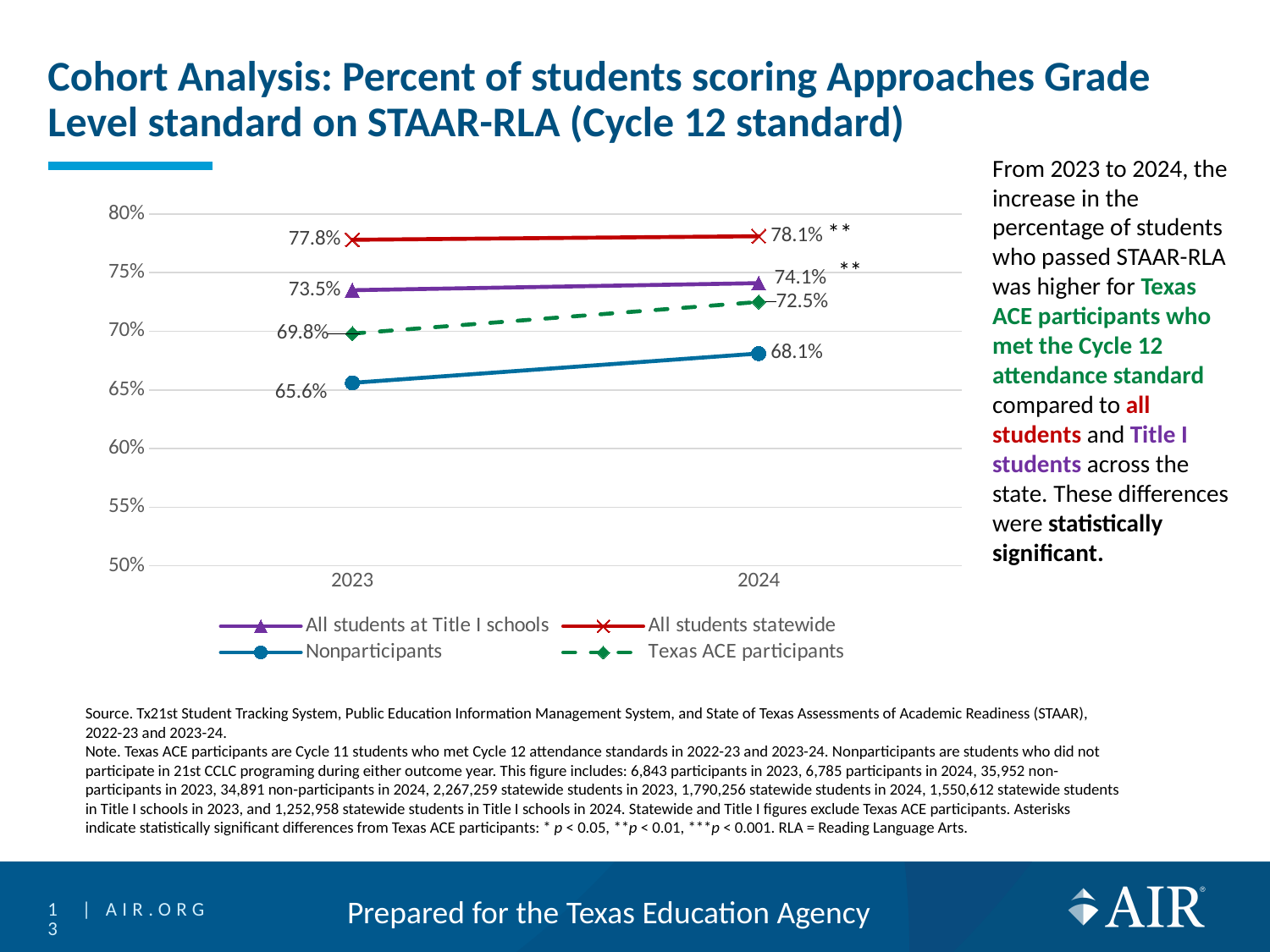
Did the value for Nonparticipants rise or fall from 2023 to 2024? rise Which was larger in 2023: the value for Texas ACE participants or the value for All students at Title I schools? All students at Title I schools What was the value for All students statewide in 2023? 77.8% What type of chart is shown on the slide? line chart What was the value for All students at Title I schools in 2024? 74.1% What was the value for Nonparticipants in 2023? 65.6% By how many percentage points did the value for Texas ACE participants change from 2023 to 2024? 2.7 What is the difference between the 2024 values for All students statewide and Nonparticipants? 10 Which series had the lowest value in 2023? Nonparticipants What was the value for Texas ACE participants in 2024? 72.5% Which series had the highest value in 2024? All students statewide How many series does the legend list? 4